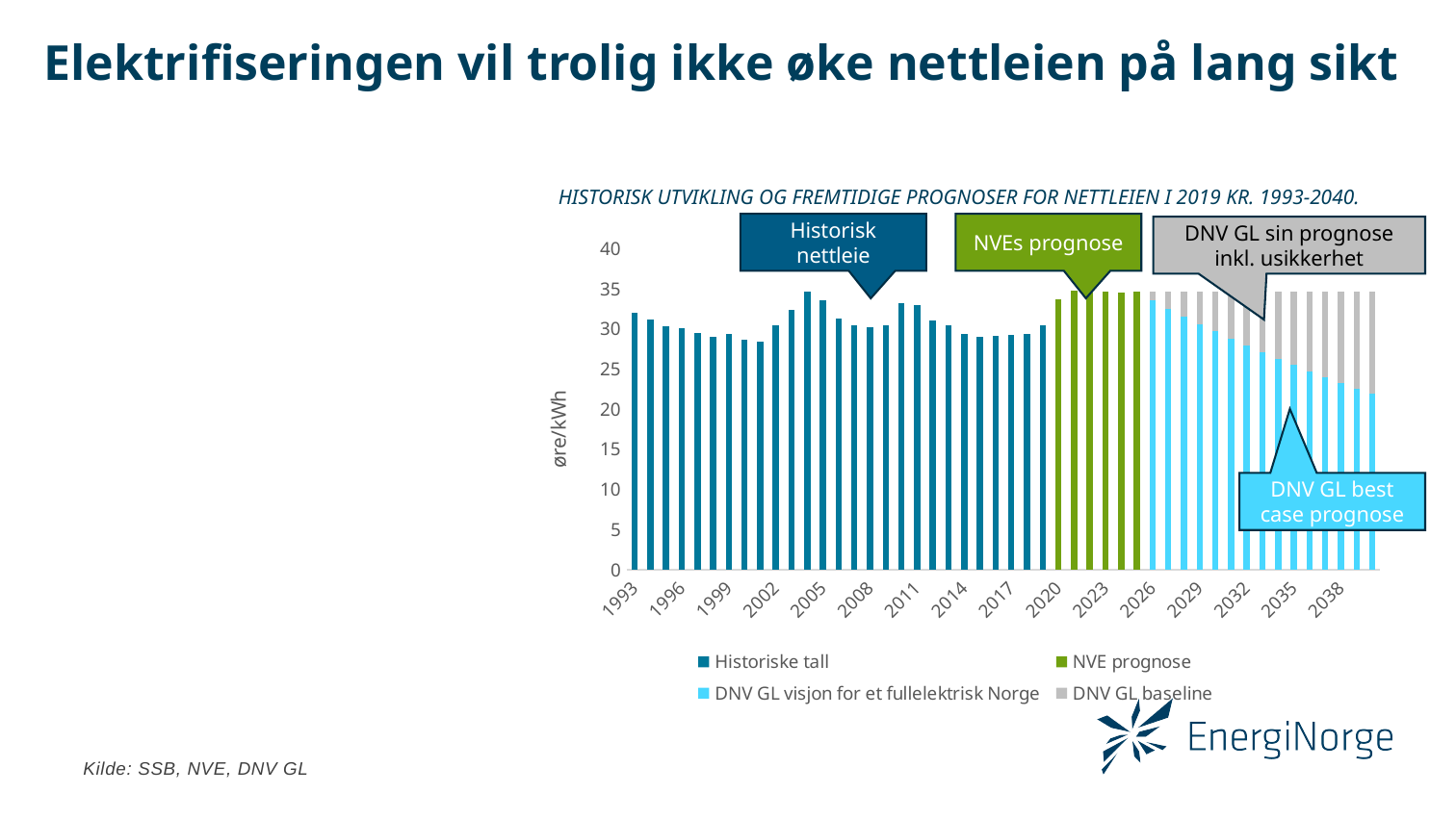
What kind of chart is shown on the slide? bar chart Is the DNV GL visjon for et fullelektrisk Norge value for 2040 greater or less than 25? less Which is larger, the value for 2005 or the value for 2003? 2005 Do the DNV GL visjon for et fullelektrisk Norge values rise or fall from 2026 to 2040? fall What is the title of the chart? HISTORISK UTVIKLING OG FREMTIDIGE PROGNOSER FOR NETTLEIEN I 2019 KR. 1993-2040. Is the value for 2017 greater or less than 30? less Among the Historiske tall bars, which year has the highest value? 2004 Is the value for 2003 greater or less than 30? greater What is the label on the vertical axis of the chart? øre/kWh How many series does the chart legend list? 4